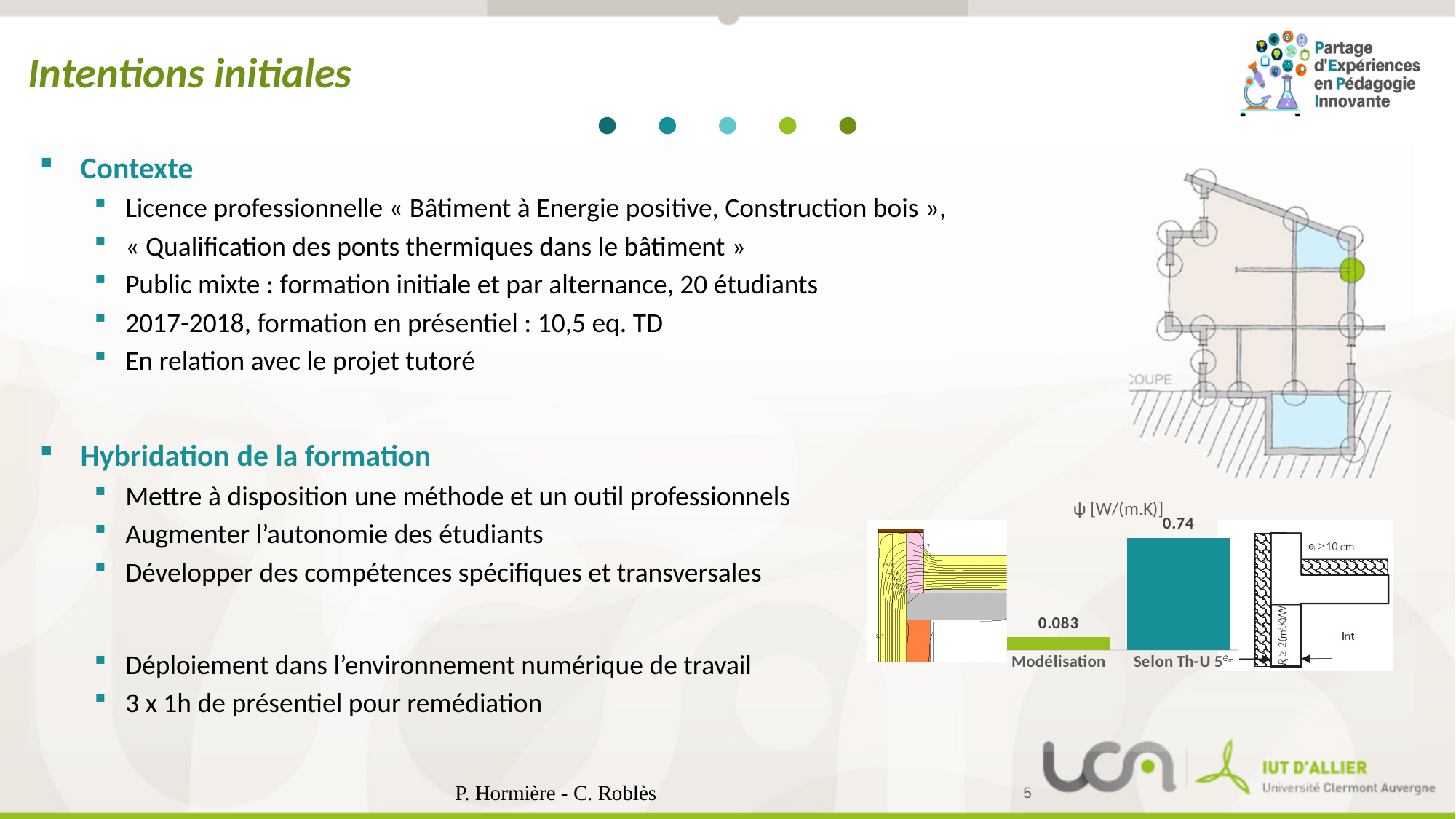
What is the difference between the Selon Th-U 5em value and the Modélisation value in the bar chart? 0.657 Which category has the lowest value in the bar chart? Modélisation What colour is the Modélisation bar in the bar chart? green What is the value for Selon Th-U 5em in the bar chart? 0.74 What kind of chart is shown at the bottom right of the slide? bar chart Which is larger in the bar chart, Modélisation or Selon Th-U 5em? Selon Th-U 5em How many bars are shown in the bar chart? 2 What quantity and unit does the bar chart's axis label indicate? ψ [W/(m.K)] What is the value for Modélisation in the bar chart? 0.083 Which category has the highest value in the bar chart? Selon Th-U 5em